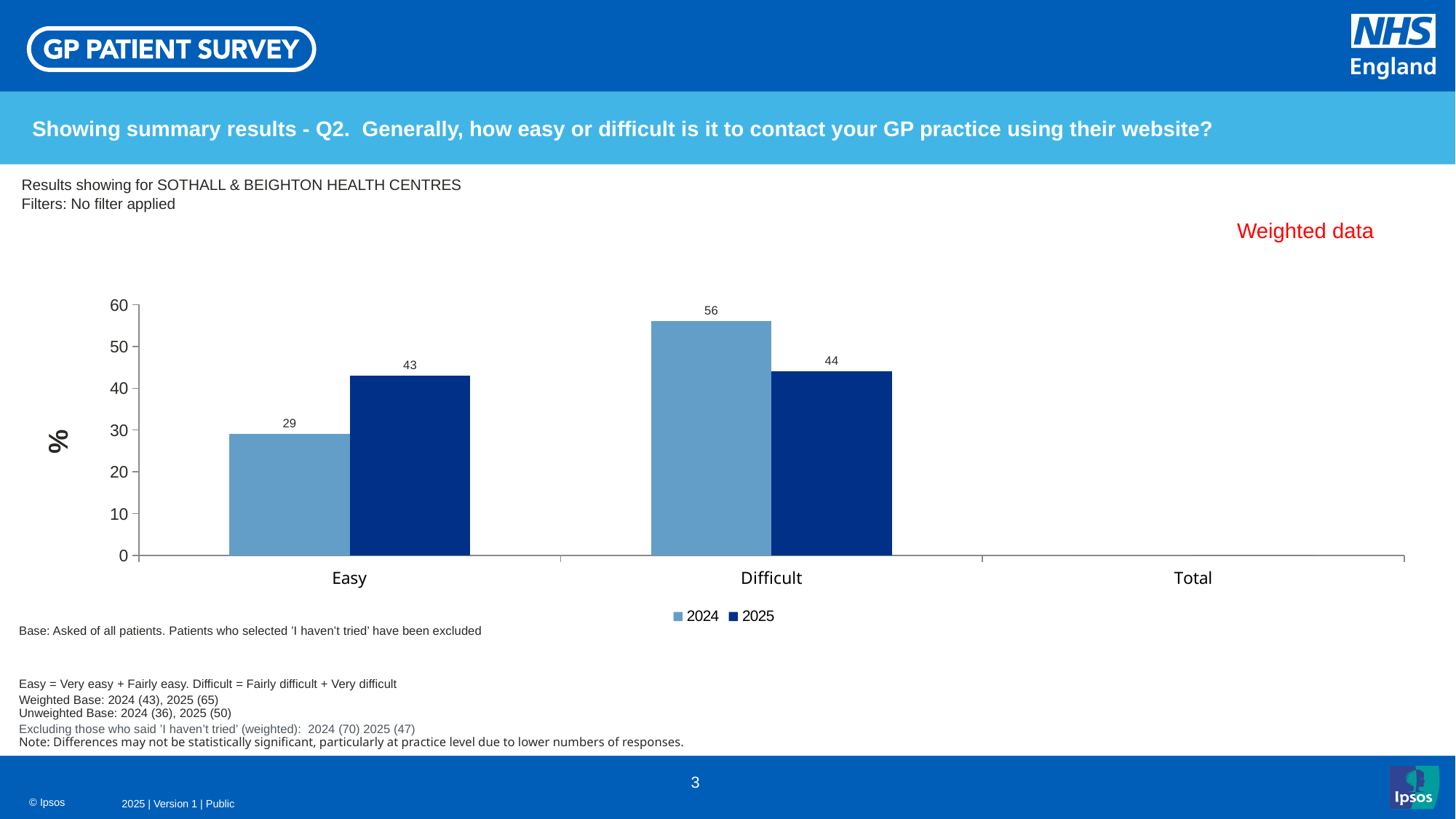
What is the value for Difficult in 2025? 44 What is the difference between the 2024 and 2025 values for Difficult? 12 Which category has the lowest value for the 2024 series? Easy What is the value for Easy in 2024? 29 What is the difference between the 2025 and 2024 values for Easy? 14 What is the value for Easy in 2025? 43 What is the value for Difficult in 2024? 56 What are the series names listed in the legend? 2024 and 2025 How many series does the legend list? 2 Which category has the highest value for the 2024 series? Difficult What kind of chart is shown on the slide? Bar chart Which is larger: the 2024 value for Difficult or the 2025 value for Difficult? 2024